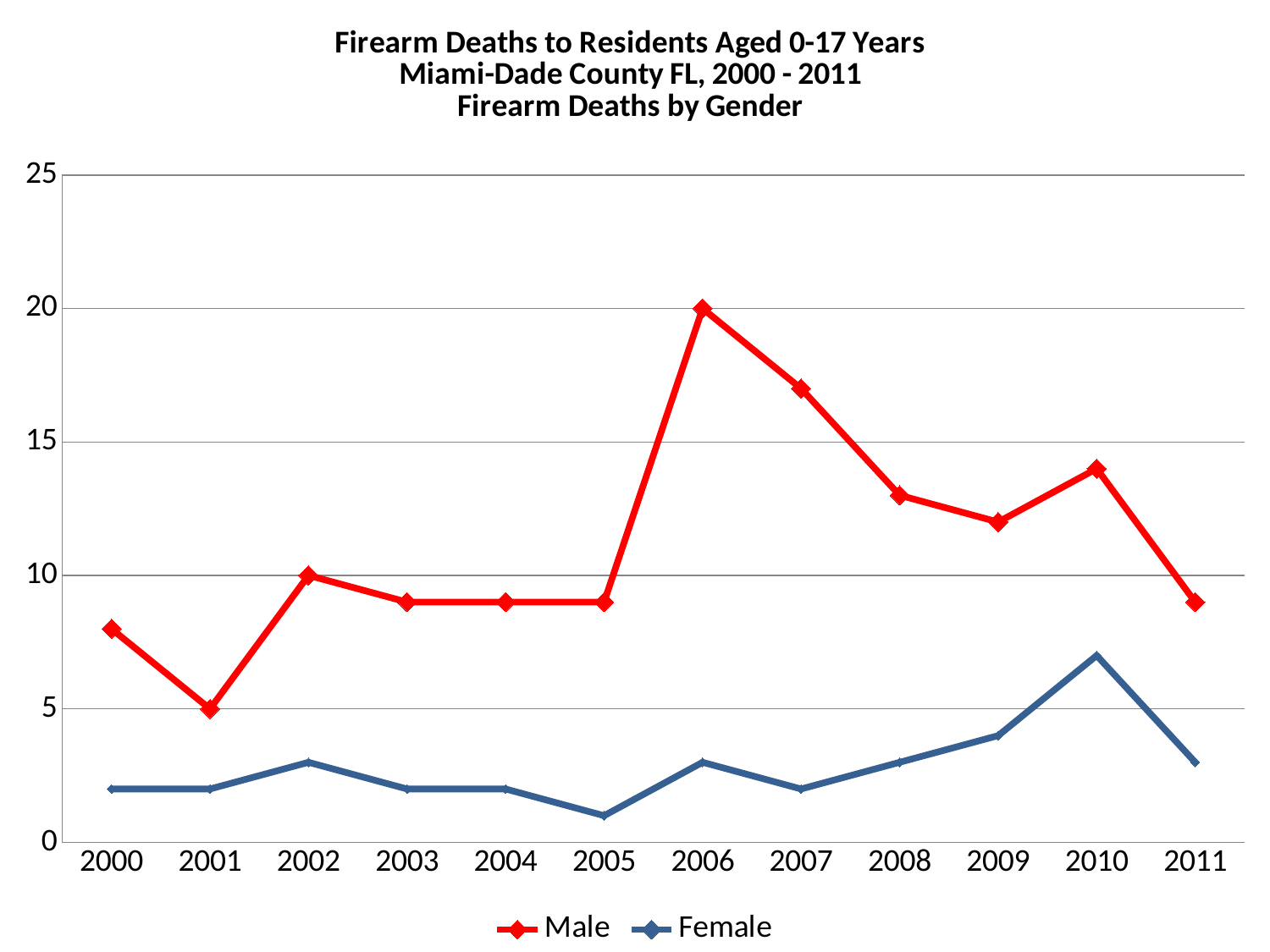
Is the Female value for 2010 greater or less than 5? greater In which year is the Female series at its highest? 2010 How many years are plotted along the x axis? 12 In which year is the Male series at its lowest? 2001 What is the Male value in 2002? 10 Does the Male series rise or fall from 2006 to 2009? Fall In which year is the Male series at its highest? 2006 What is the Male value in 2006? 20 How many series does the legend list? 2 Which series has the larger value in 2006, Male or Female? Male What type of chart is shown on the slide? Line chart Is the Male value for 2007 greater or less than 15? greater